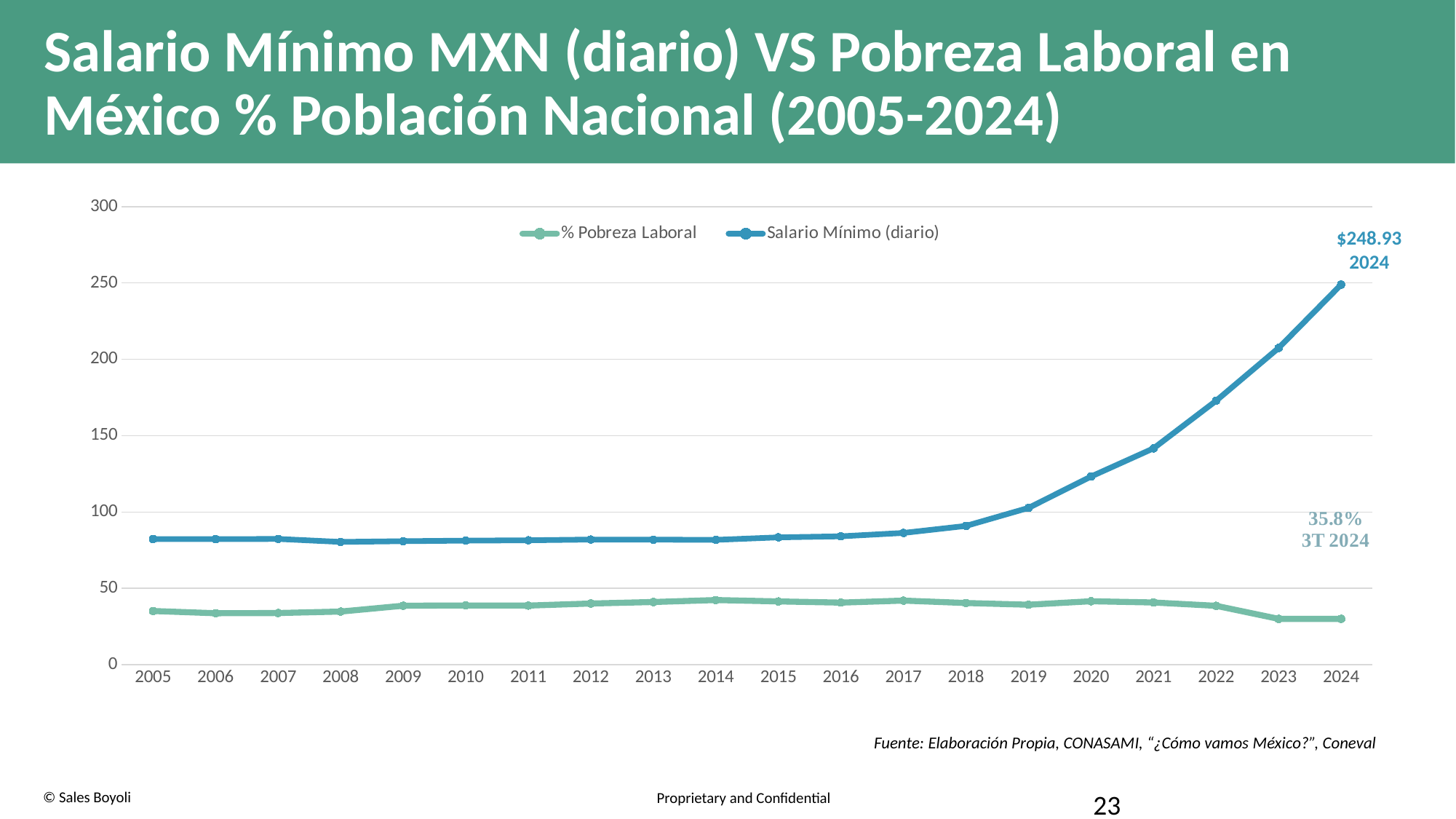
Is the value for Salario Mínimo (diario) in 2005 greater or less than 100? less How many series does the legend list? 2 Is the value for Salario Mínimo (diario) in 2022 greater or less than 150? greater In which year is Salario Mínimo (diario) highest? 2024 What colour is the Salario Mínimo (diario) line? blue What kind of chart is shown on the slide? line chart Is the value for % Pobreza Laboral in 2014 greater or less than 50? less What is the value of % Pobreza Laboral labelled for 3T 2024? 35.8% How many years are plotted along the x axis? 20 What is the value of Salario Mínimo (diario) in 2024? $248.93 Which is larger: % Pobreza Laboral in 2014 or in 2023? 2014 Does Salario Mínimo (diario) rise or fall from 2018 to 2024? rise